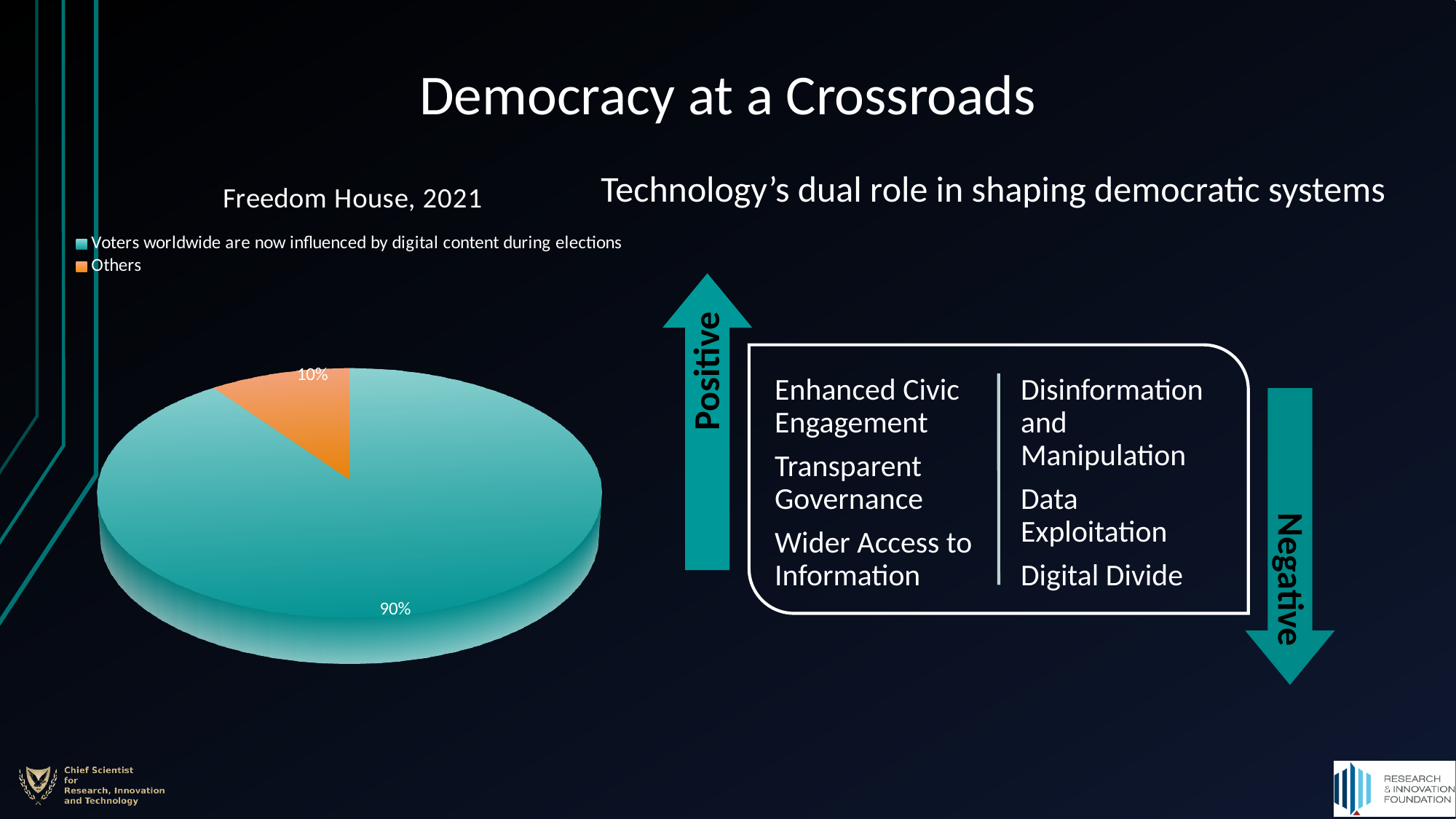
Which slice of the pie is the largest? Voters worldwide are now influenced by digital content during elections What is the title of the chart? Freedom House, 2021 Which slice of the pie is the smallest? Others What type of chart is shown on the slide? Pie chart Which is larger: the 'Others' slice or the 'Voters worldwide are now influenced by digital content during elections' slice? Voters worldwide are now influenced by digital content during elections What colour is the 'Others' slice in the pie chart? Orange How many entries does the chart legend list? 2 What share of the pie is labelled 'Others'? 10% What is the difference in percentage points between the two slices of the pie? 80 What share of the pie is labelled 'Voters worldwide are now influenced by digital content during elections'? 90% How many slices does the pie chart have? 2